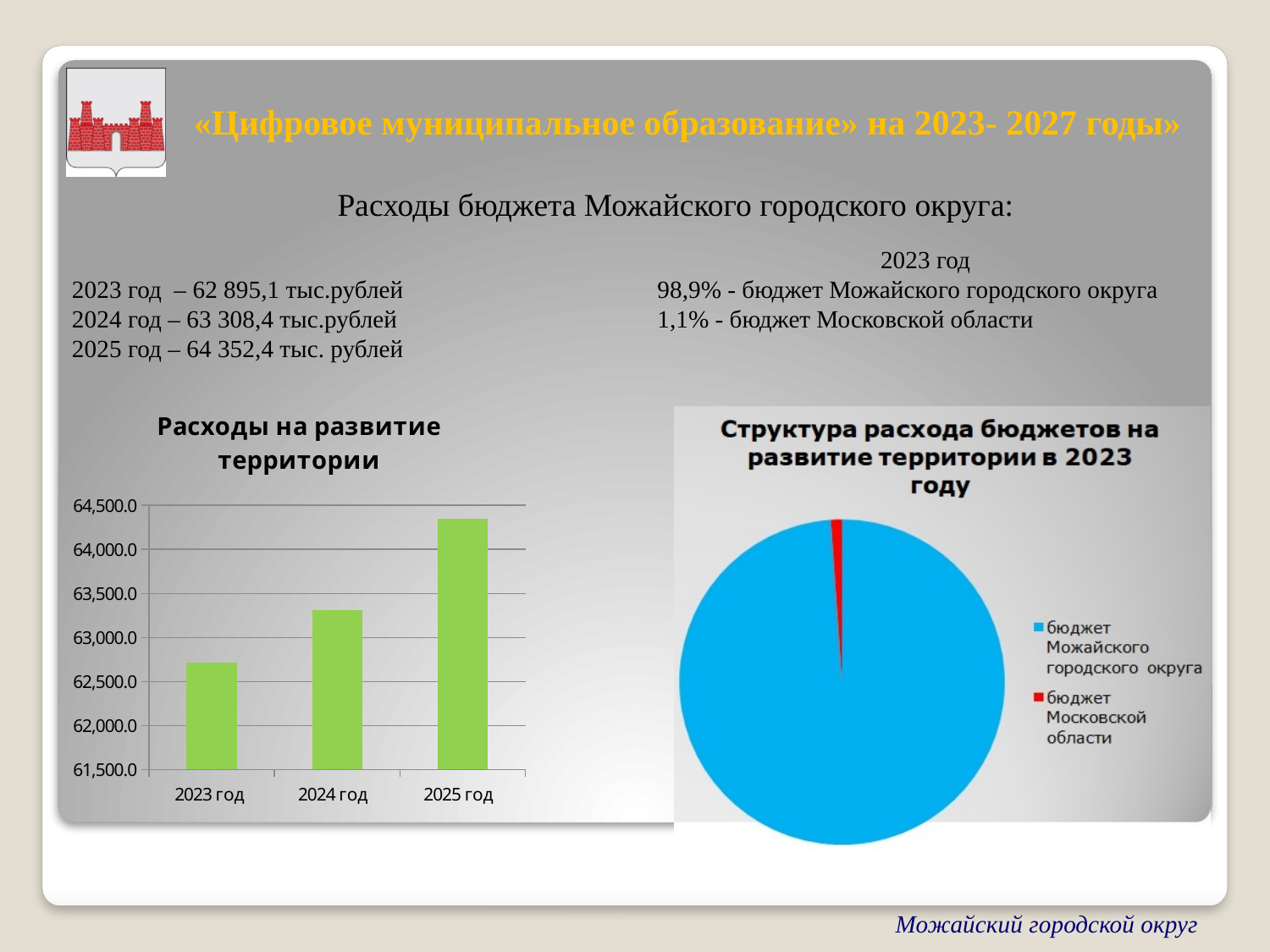
In the 'Расходы на развитие территории' chart, which year has the lowest value? 2023 год How many bars are in the 'Расходы на развитие территории' chart? 3 In the 'Структура расхода бюджетов на развитие территории в 2023 году' pie chart, what colour is the slice for бюджет Московской области? red In the 'Расходы на развитие территории' chart, do the values rise or fall from 2023 to 2025? rise What kind of chart is the 'Структура расхода бюджетов на развитие территории в 2023 году' chart? pie chart In the 'Расходы на развитие территории' chart, is the value for 2023 год greater or less than 63,000.0? less In the 'Структура расхода бюджетов на развитие территории в 2023 году' pie chart, which slice is larger: бюджет Можайского городского округа or бюджет Московской области? бюджет Можайского городского округа How many entries does the legend of the 'Структура расхода бюджетов на развитие территории в 2023 году' pie chart list? 2 In the 'Расходы на развитие территории' chart, which year has the highest value? 2025 год What kind of chart is the 'Расходы на развитие территории' chart? bar chart In the 'Расходы на развитие территории' chart, is the value for 2025 год greater or less than 64,000.0? greater In the 'Расходы на развитие территории' chart, is the value for 2024 год greater or less than 63,000.0? greater